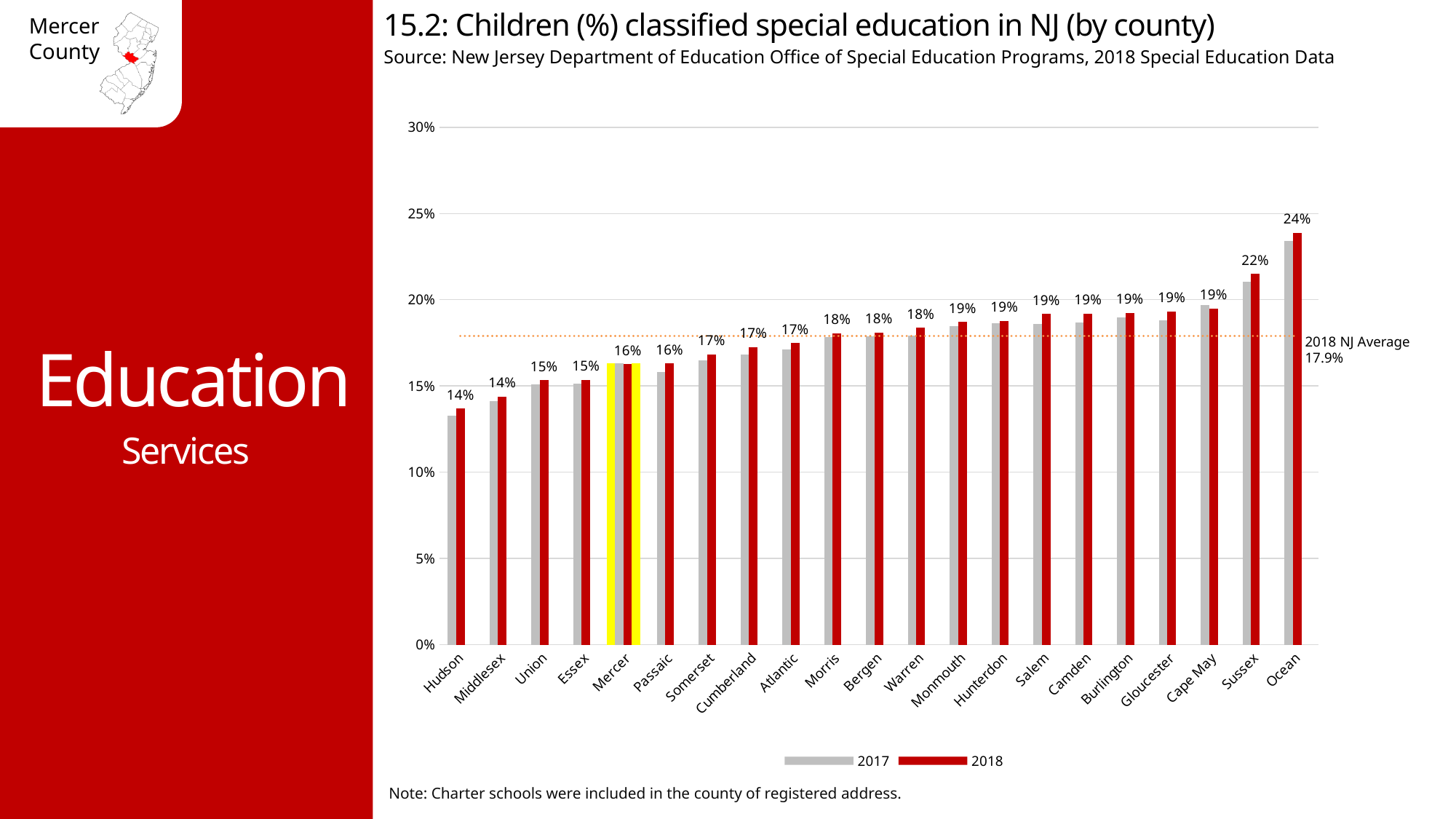
What is the 2018 NJ average shown by the dotted line? 17.9% What kind of chart is shown? bar chart Which county has the highest 2018 value? Ocean Is the 2017 value for Hudson greater or less than 15%? less How many series does the legend list? 2 What is the difference between the 2018 values for Ocean and Hudson? 10 percentage points What is the 2018 value for Ocean county? 24% How many counties are shown on the x axis? 21 What is the 2018 value for Sussex county? 22% Which has the larger 2018 value, Sussex or Cape May? Sussex What is the 2018 value for Mercer county? 16% Do the 2018 values rise or fall from Hudson to Ocean along the x axis? rise